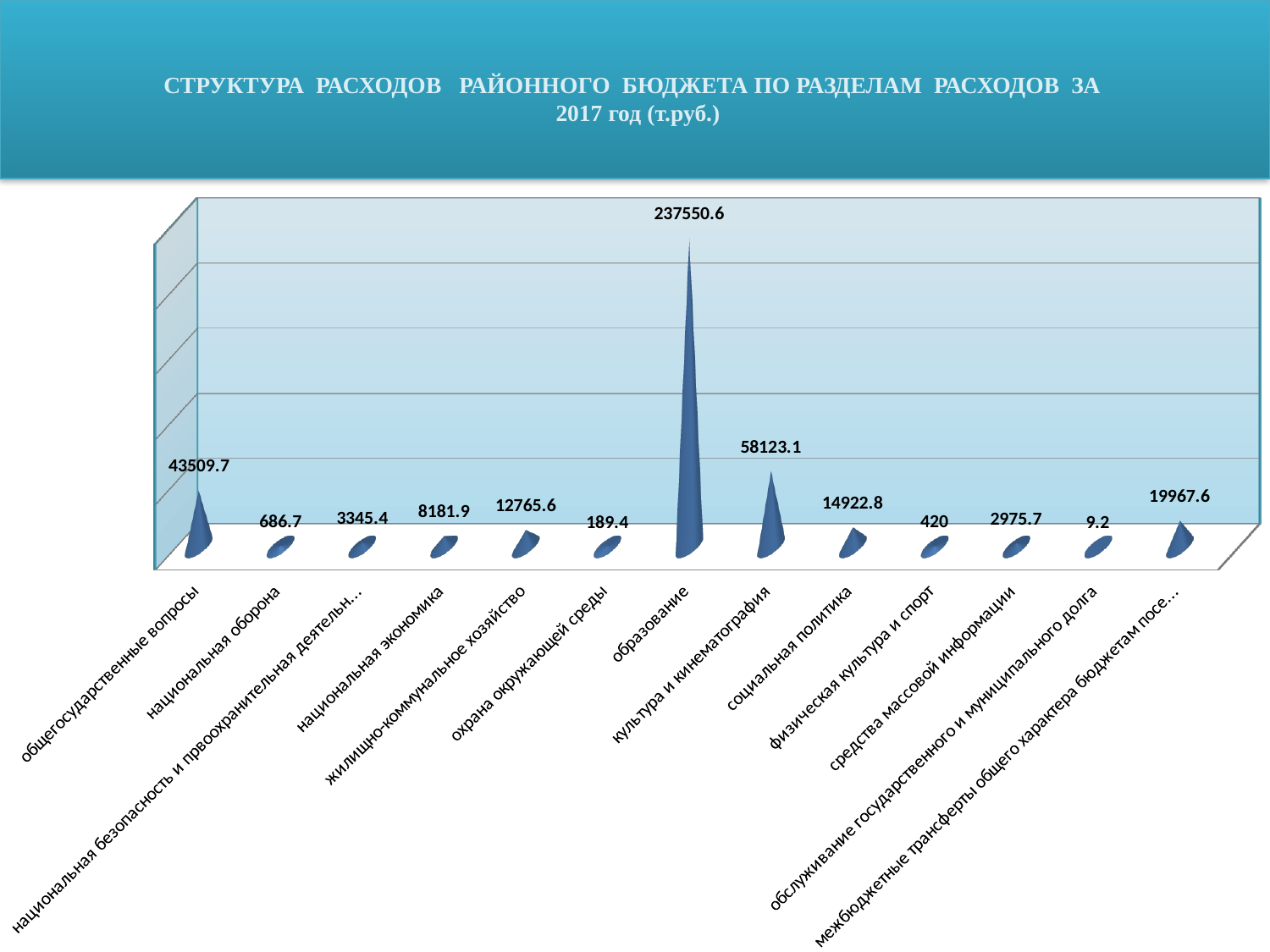
Which category has the lowest value? обслуживание государственного и муниципального долга What kind of chart is shown on the slide? bar chart What is the value for жилищно-коммунальное хозяйство? 12765.6 What is the value for культура и кинематография? 58123.1 What is the difference between the values for общегосударственные вопросы and жилищно-коммунальное хозяйство? 30744.1 What year does the chart title say the data is for? 2017 How many categories are shown on the x axis? 13 Which is larger, the value for социальная политика or the value for национальная экономика? социальная политика What is the difference between the values for образование and культура и кинематография? 179427.5 What is the value for обслуживание государственного и муниципального долга? 9.2 Which category has the highest value? образование What is the value for образование? 237550.6